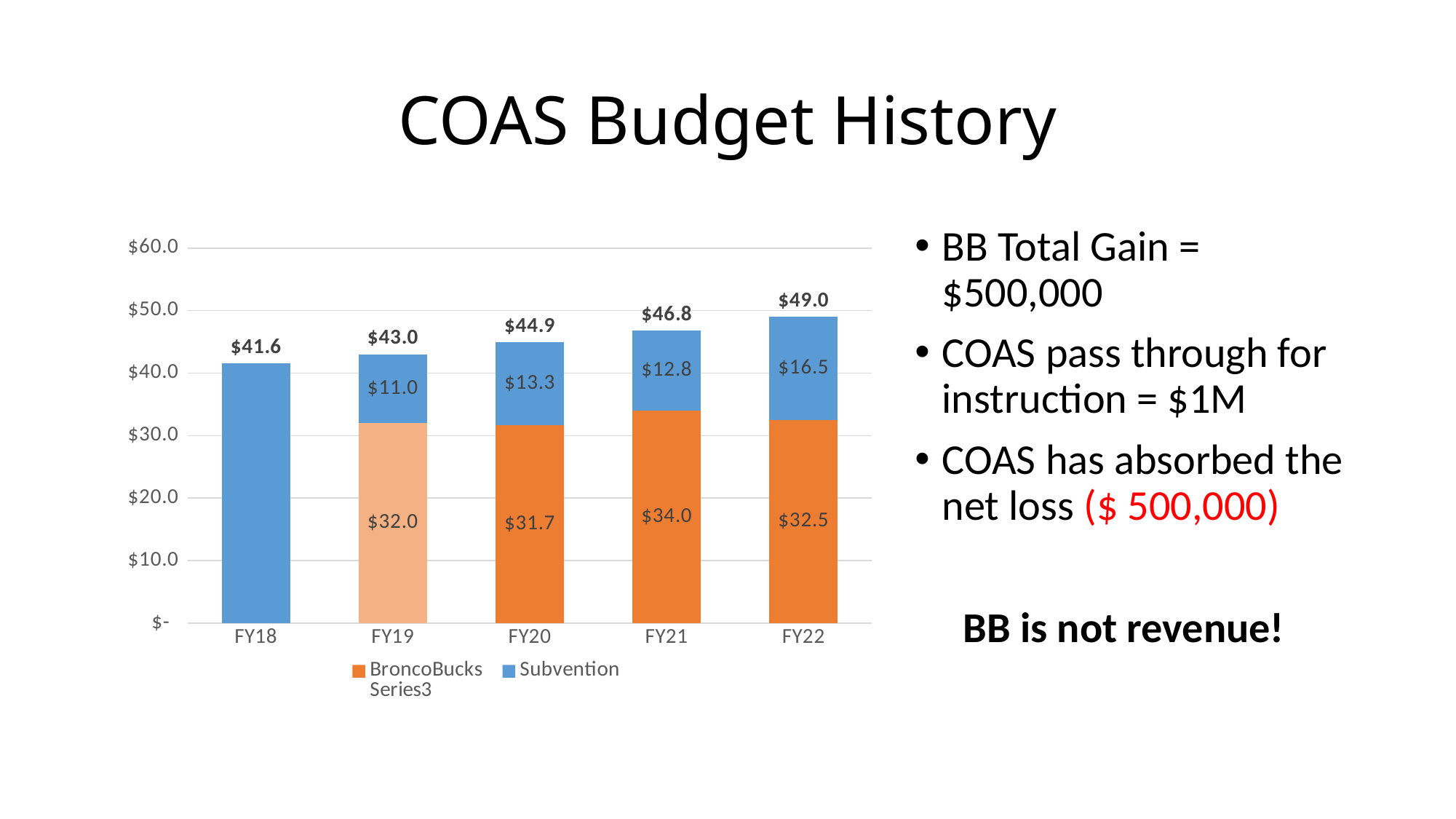
Is the total for FY19 greater or less than $40.0? greater What is the BroncoBucks value for FY21? $34.0 Which fiscal year has the lowest total bar? FY18 What is the total labelled above the FY20 bar? $44.9 What is the difference between the FY22 total and the FY18 total? $7.4 How many fiscal years are shown on the x axis? 5 What is the Subvention value for FY22? $16.5 What kind of chart is shown on the slide? Stacked bar chart How many entries does the legend list? 3 Which is larger, the Subvention value for FY20 or for FY21? FY20 Do the total bar values rise or fall from FY18 to FY22? Rise Which fiscal year has the highest total bar? FY22